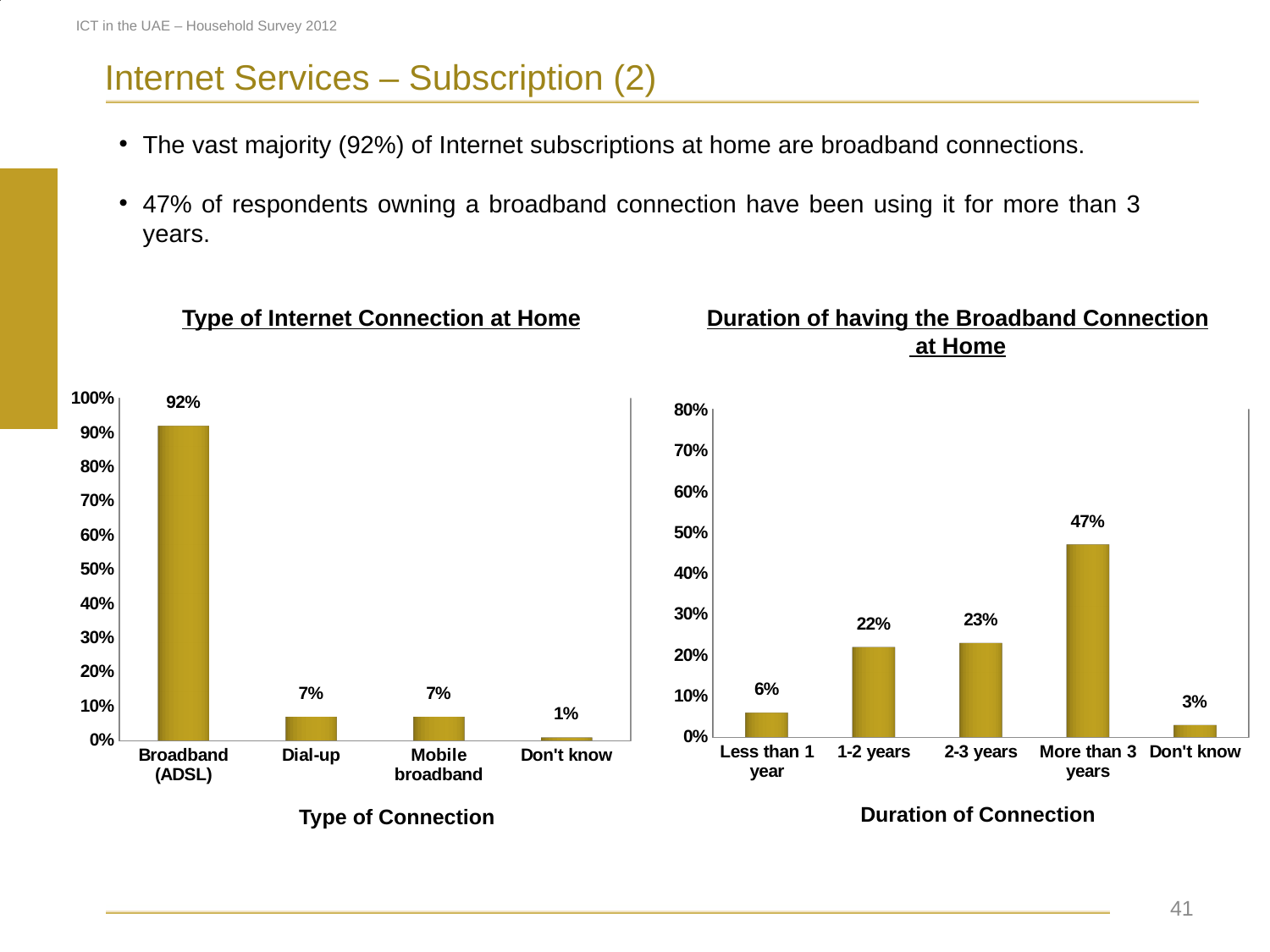
In the 'Duration of having the Broadband Connection at Home' chart, which is larger: 1-2 years or More than 3 years? More than 3 years In the 'Type of Internet Connection at Home' chart, what is the value for Broadband (ADSL)? 92% In the 'Duration of having the Broadband Connection at Home' chart, what is the value for 2-3 years? 23% In the 'Type of Internet Connection at Home' chart, how many categories are shown on the x axis? 4 In the 'Type of Internet Connection at Home' chart, what is the difference between Broadband (ADSL) and Dial-up? 85% What is the x-axis title of the 'Type of Internet Connection at Home' chart? Type of Connection In the 'Duration of having the Broadband Connection at Home' chart, what is the difference between More than 3 years and 2-3 years? 24% In the 'Duration of having the Broadband Connection at Home' chart, which category has the lowest value? Don't know In the 'Type of Internet Connection at Home' chart, which category has the highest value? Broadband (ADSL) In the 'Duration of having the Broadband Connection at Home' chart, what is the value for Less than 1 year? 6% In the 'Type of Internet Connection at Home' chart, what is the value for Don't know? 1% What kind of chart is the 'Duration of having the Broadband Connection at Home' chart? Bar chart